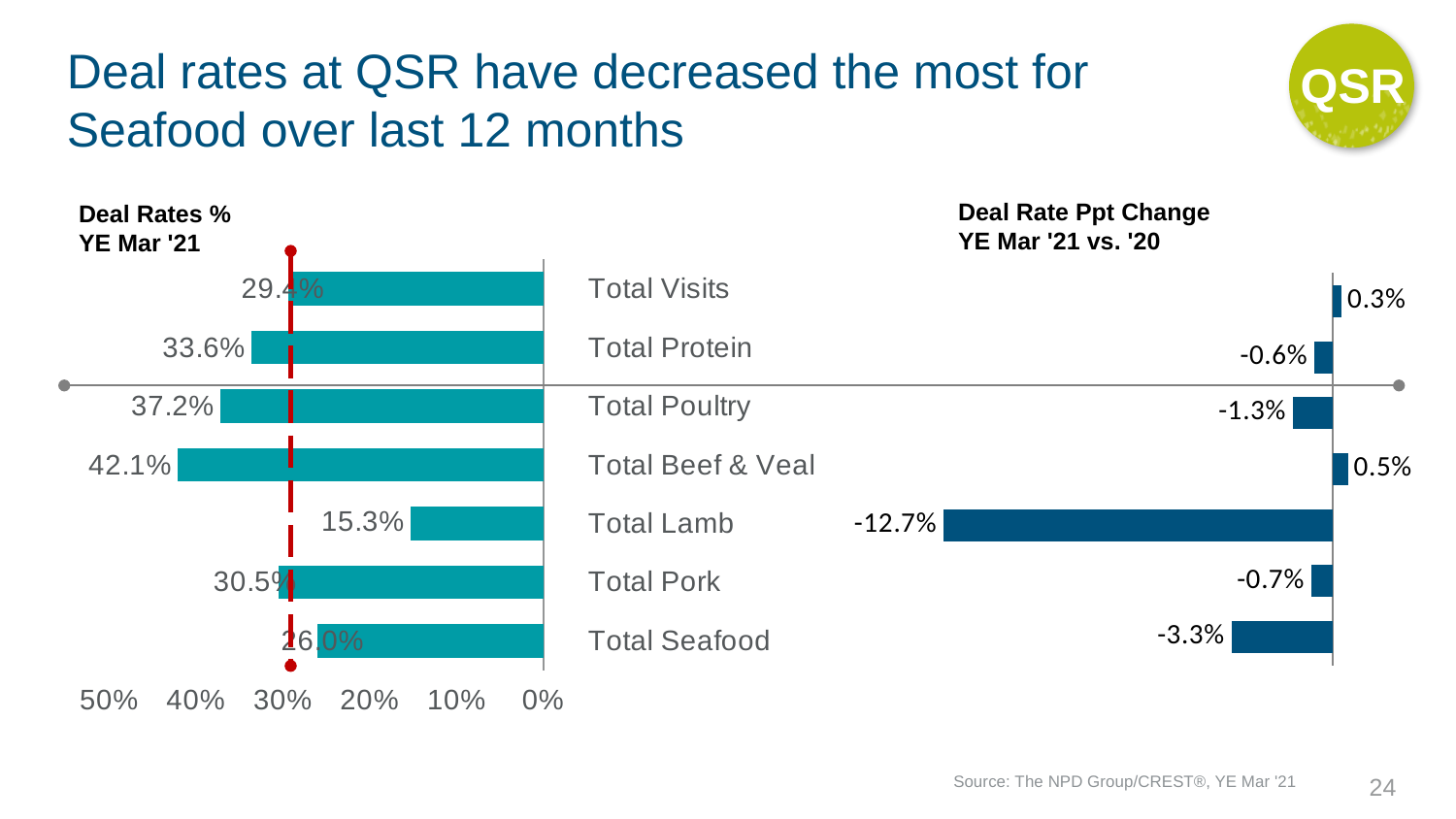
In the Deal Rates % YE Mar '21 chart, what is the difference between the deal rates for Total Poultry and Total Protein? 3.6% In the Deal Rate Ppt Change YE Mar '21 vs. '20 chart, which category has the lowest value? Total Lamb In the Deal Rates % YE Mar '21 chart, which category has the lowest deal rate? Total Lamb In the Deal Rate Ppt Change YE Mar '21 vs. '20 chart, which is larger, the value for Total Protein or the value for Total Pork? Total Protein What type of chart is the Deal Rate Ppt Change YE Mar '21 vs. '20 chart? Bar chart In the Deal Rate Ppt Change YE Mar '21 vs. '20 chart, which category has the highest value? Total Beef & Veal In the Deal Rate Ppt Change YE Mar '21 vs. '20 chart, what is the value for Total Seafood? -3.3% In the Deal Rates % YE Mar '21 chart, which category has the highest deal rate? Total Beef & Veal In the Deal Rate Ppt Change YE Mar '21 vs. '20 chart, what is the value for Total Lamb? -12.7% In the Deal Rates % YE Mar '21 chart, what is the deal rate for Total Lamb? 15.3% In the Deal Rates % YE Mar '21 chart, what is the deal rate for Total Beef & Veal? 42.1% How many categories are shown in the Deal Rates % YE Mar '21 chart? 7